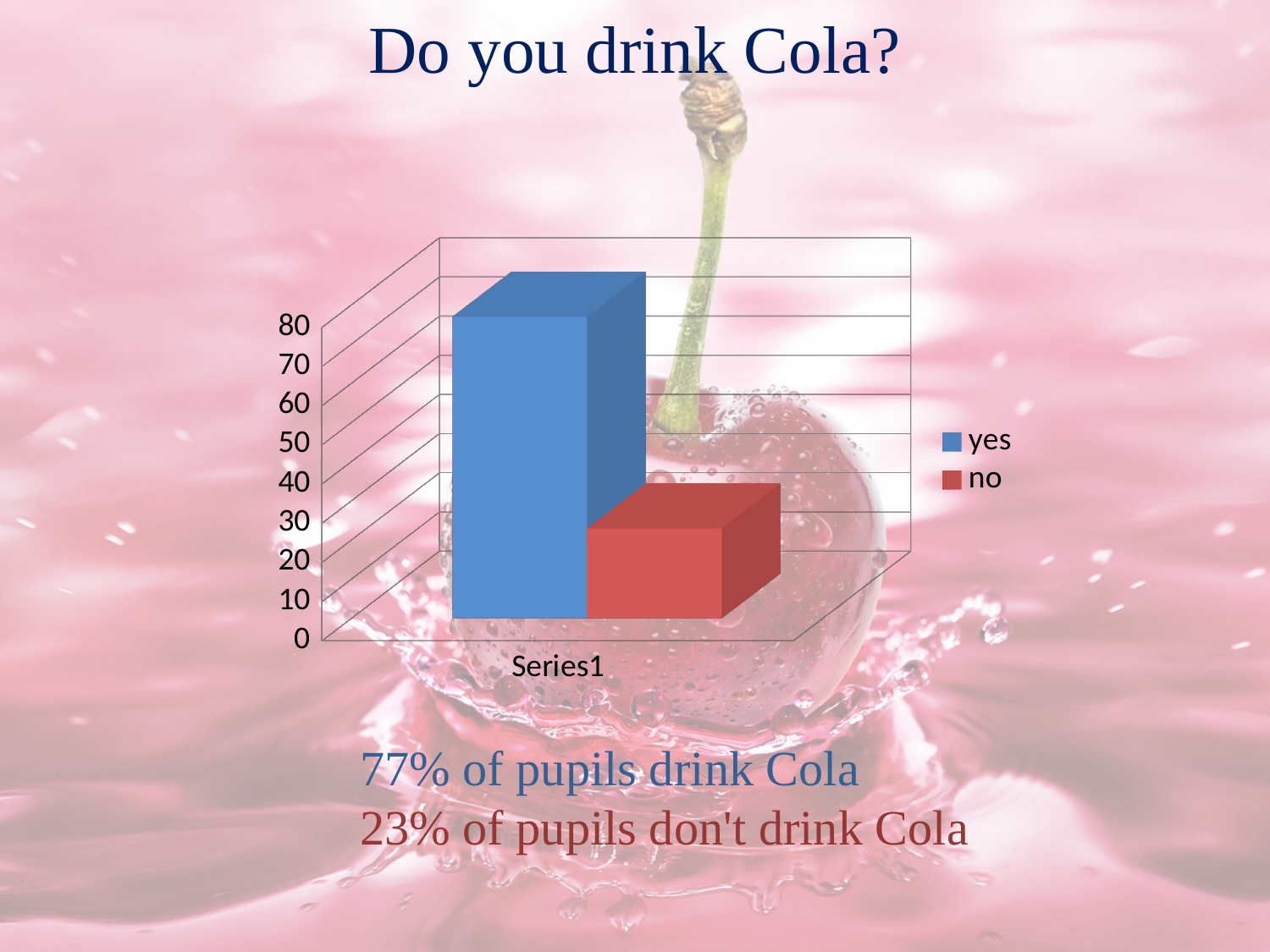
Which series has the lowest bar in the chart? no What colour is the bar for the yes series? blue Is the value for yes greater or less than 60? greater Is the value for no greater or less than 50? less What is the category label shown on the x axis of the chart? Series1 What kind of chart is shown on the slide? bar chart Which bar is taller, yes or no? yes Is the value for yes greater or less than 50? greater Which series has the highest bar in the chart? yes How many series does the chart legend list? 2 What is the title of the slide with the chart? Do you drink Cola?